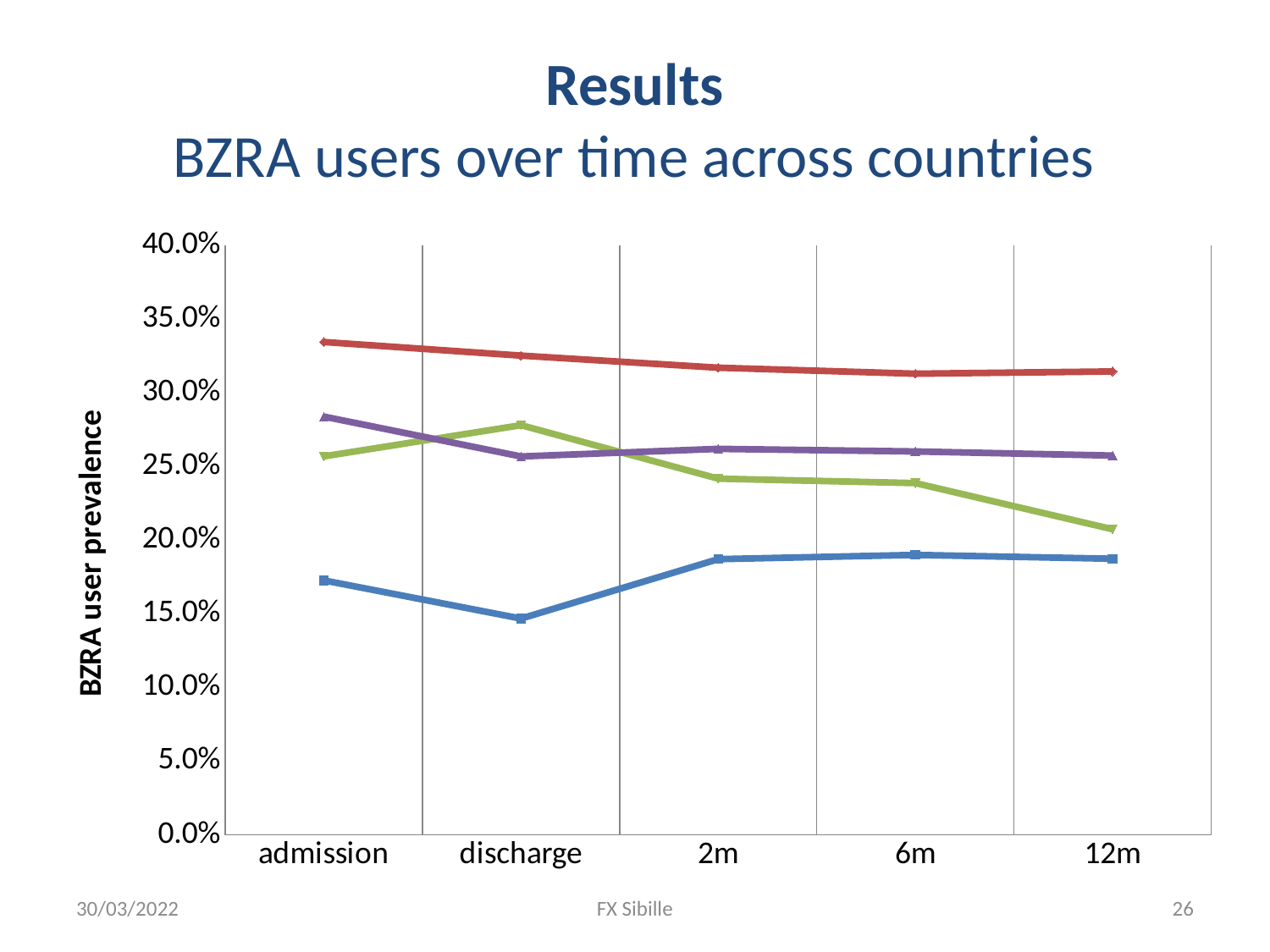
Which line is lowest at 12m? the blue line Is the value of the blue line at discharge greater or less than 20.0%? less How many time points are shown on the x axis of the chart? 5 What kind of chart is shown on the slide? line chart Is the value of the red line at admission greater or less than 30.0%? greater Is the value of the purple line at admission greater or less than 25.0%? greater Does the green line rise or fall from discharge to 12m? fall At discharge, which is larger: the green line or the purple line? the green line At 12m, which is larger: the purple line or the green line? the purple line Which line is highest at admission? the red line What is the label of the vertical axis of the chart? BZRA user prevalence